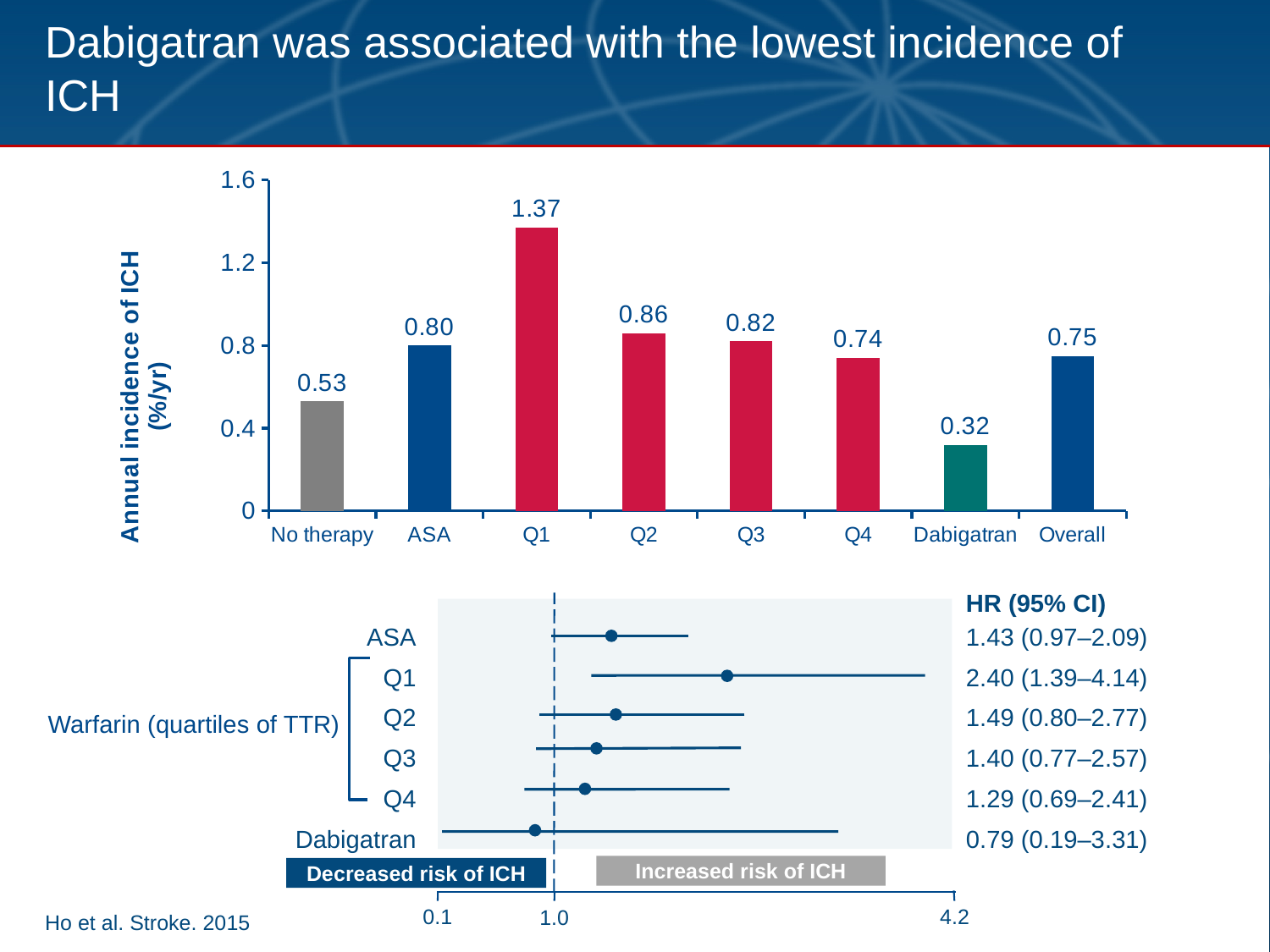
What kind of chart is the top chart on the slide? Bar chart In the top bar chart, what is the annual incidence of ICH for Dabigatran? 0.32 In the top bar chart, what is the difference between the values for Q1 and Dabigatran? 1.05 In the top bar chart, which category has the highest annual incidence of ICH? Q1 In the top bar chart, which is larger, the value for ASA or the value for No therapy? ASA In the top bar chart, how many categories are shown on the x axis? 8 In the top bar chart, which category has the lowest annual incidence of ICH? Dabigatran In the top bar chart, what is the value for Overall? 0.75 In the bottom forest plot, what is the HR (95% CI) for Q1? 2.40 (1.39–4.14) In the bottom forest plot, which treatment has the lowest hazard ratio? Dabigatran In the bottom forest plot, how many treatment rows are plotted? 6 In the top bar chart, what is the annual incidence of ICH for Q1? 1.37